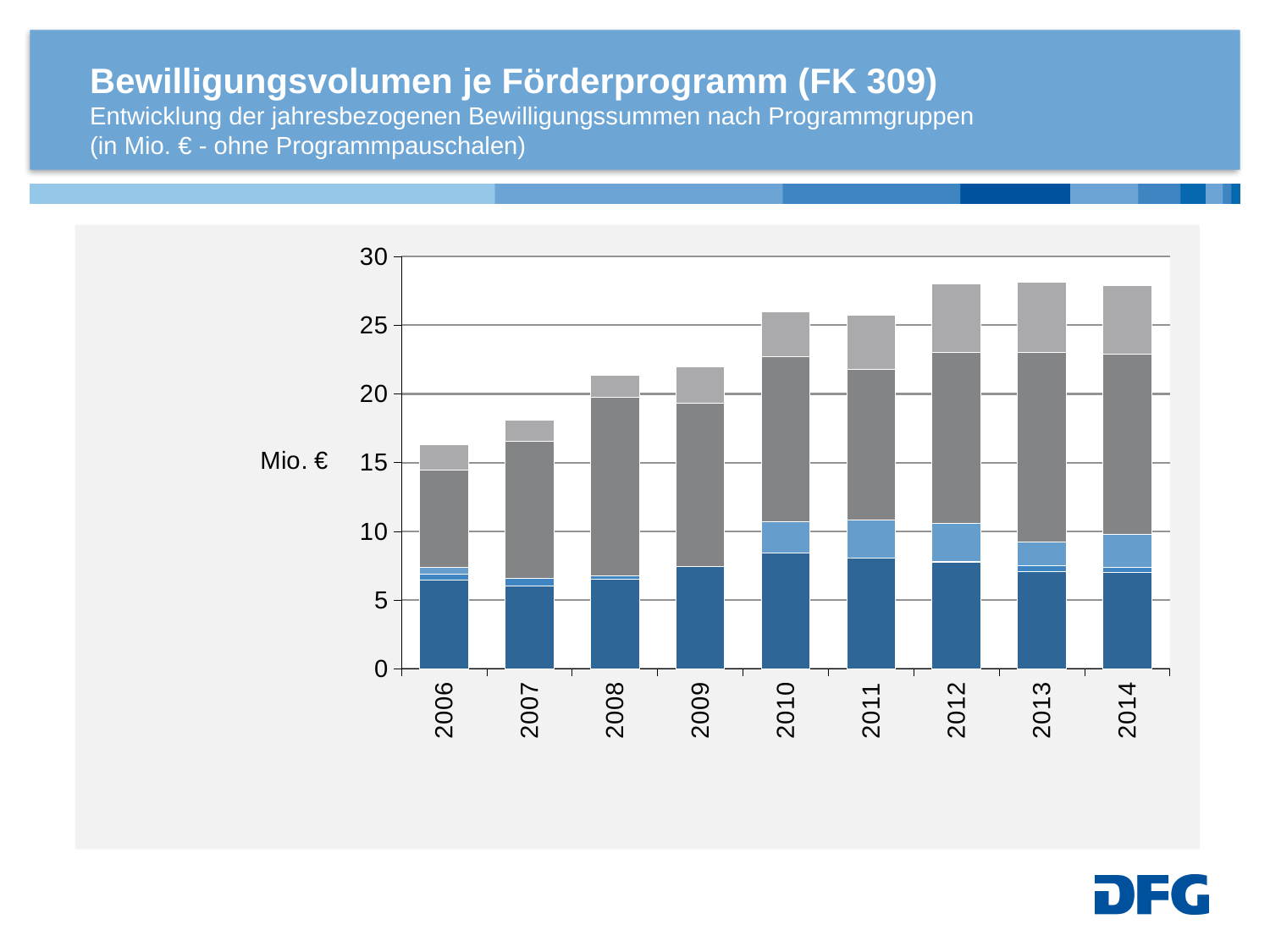
Is the total value for 2013 greater or less than 25? greater How many years are shown on the x axis of the chart? 9 Do the total bar values generally rise or fall from 2006 to 2014? rise Is the total value for 2006 greater or less than 20? less Is the total value for 2008 greater or less than 20? greater What kind of chart is shown on the slide? stacked bar chart What is the label on the y axis of the chart? Mio. € Which year has the larger total bar, 2007 or 2011? 2011 Which year has the lowest total bar in the chart? 2006 What is the title of the slide containing the chart? Bewilligungsvolumen je Förderprogramm (FK 309)